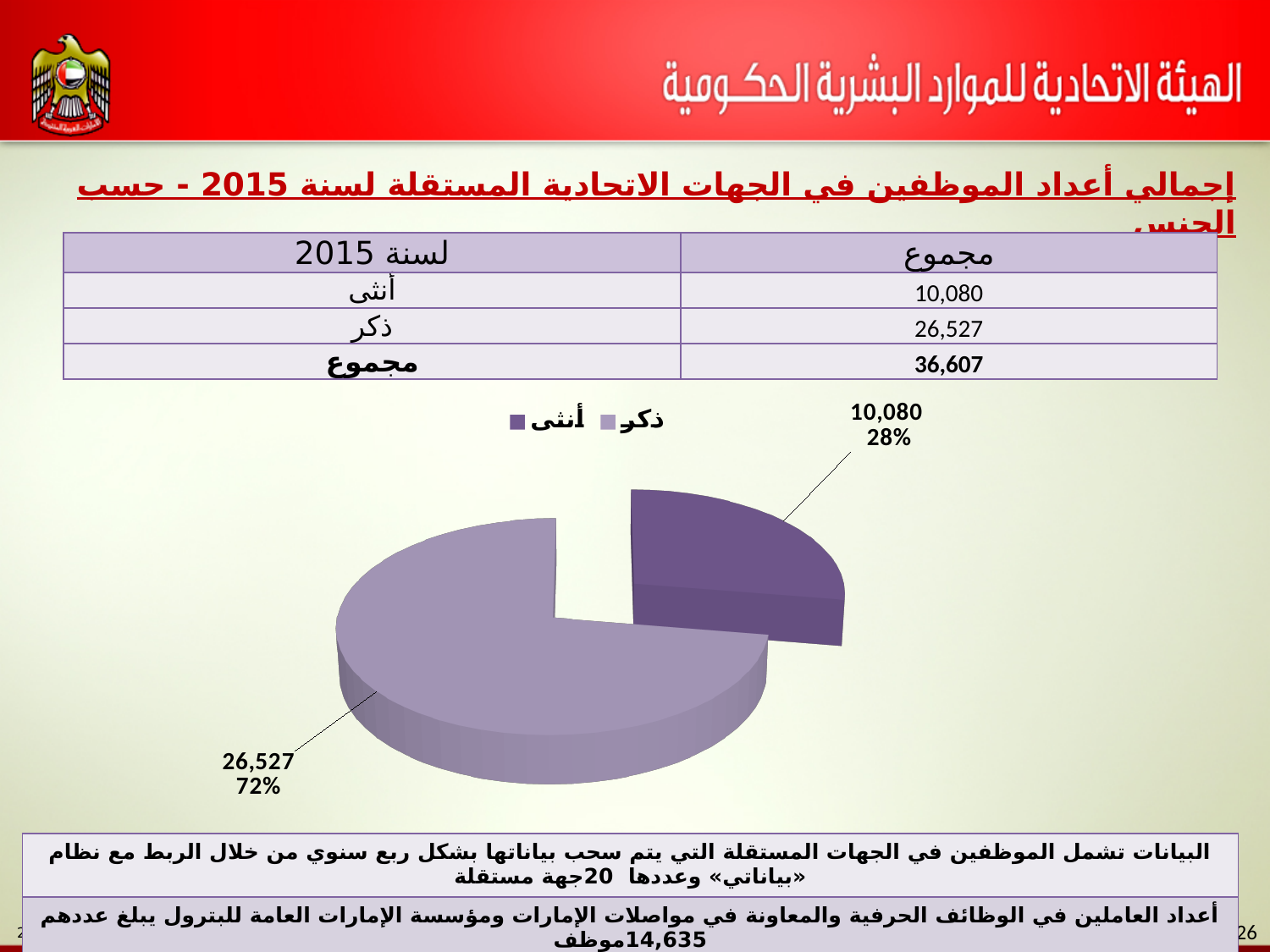
How many slices does the pie chart have? 2 How many entries does the pie chart's legend list? 2 What value is shown for the أنثى (female) slice of the pie chart? 10,080 What is the difference between the ذكر (male) value and the أنثى (female) value in the pie chart? 16,447 What type of chart is shown on the slide? pie chart Which slice of the pie chart is the largest? ذكر What percentage share of the pie does the أنثى (female) slice represent? 28% Which slice of the pie chart is the smallest? أنثى What percentage share of the pie does the ذكر (male) slice represent? 72% What value is shown for the ذكر (male) slice of the pie chart? 26,527 Which is larger in the pie chart, the ذكر (male) slice or the أنثى (female) slice? ذكر What is the total of the two values shown in the pie chart? 36,607